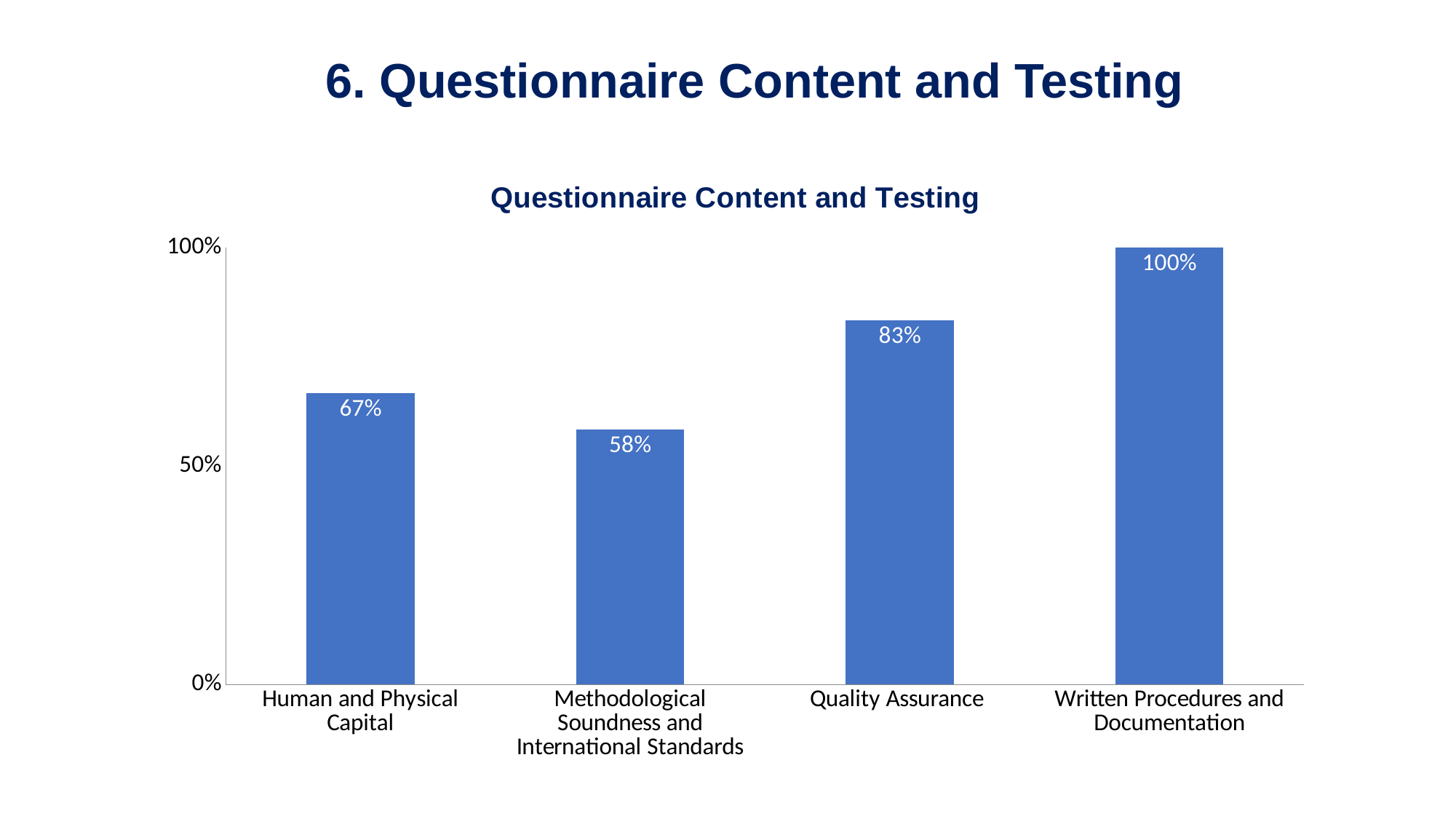
Which is larger, the value for Human and Physical Capital or the value for Methodological Soundness and International Standards? Human and Physical Capital What is the value for Written Procedures and Documentation? 100% What is the title of the chart? Questionnaire Content and Testing What is the value for Human and Physical Capital? 67% What is the value for Quality Assurance? 83% Is the value for Methodological Soundness and International Standards greater or less than 50%? greater Which category has the highest value? Written Procedures and Documentation What is the difference between the values for Quality Assurance and Human and Physical Capital? 16% Which category has the lowest value? Methodological Soundness and International Standards How many categories are shown on the chart? 4 What is the value for Methodological Soundness and International Standards? 58% What kind of chart is shown on the slide? Bar chart